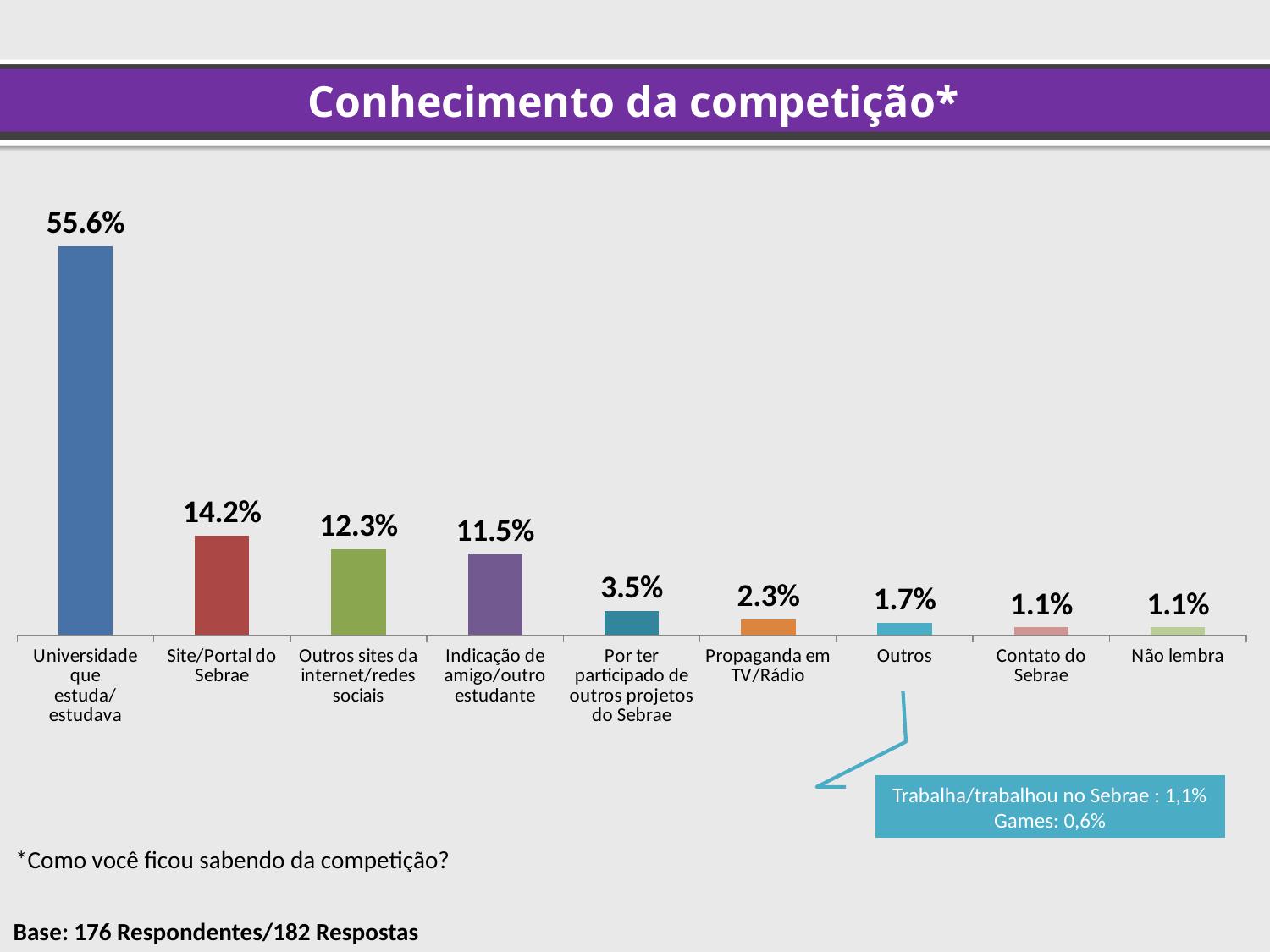
What is the difference between the values for "Universidade que estuda/estudava" and "Site/Portal do Sebrae"? 41.4 percentage points Which is larger, the value for "Por ter participado de outros projetos do Sebrae" or the value for "Outros"? Por ter participado de outros projetos do Sebrae Which category has the highest value? Universidade que estuda/estudava What is the value for "Propaganda em TV/Rádio"? 2.3% What is the value for "Site/Portal do Sebrae"? 14.2% How many categories are shown in the chart? 9 What is the difference between the values for "Site/Portal do Sebrae" and "Outros sites da internet/redes sociais"? 1.9 percentage points What is the value for "Universidade que estuda/estudava"? 55.6% What is the value for "Indicação de amigo/outro estudante"? 11.5% Do the values rise or fall from left to right along the x axis? Fall What is the title of the chart? Conhecimento da competição* What kind of chart is shown on the slide? Bar chart